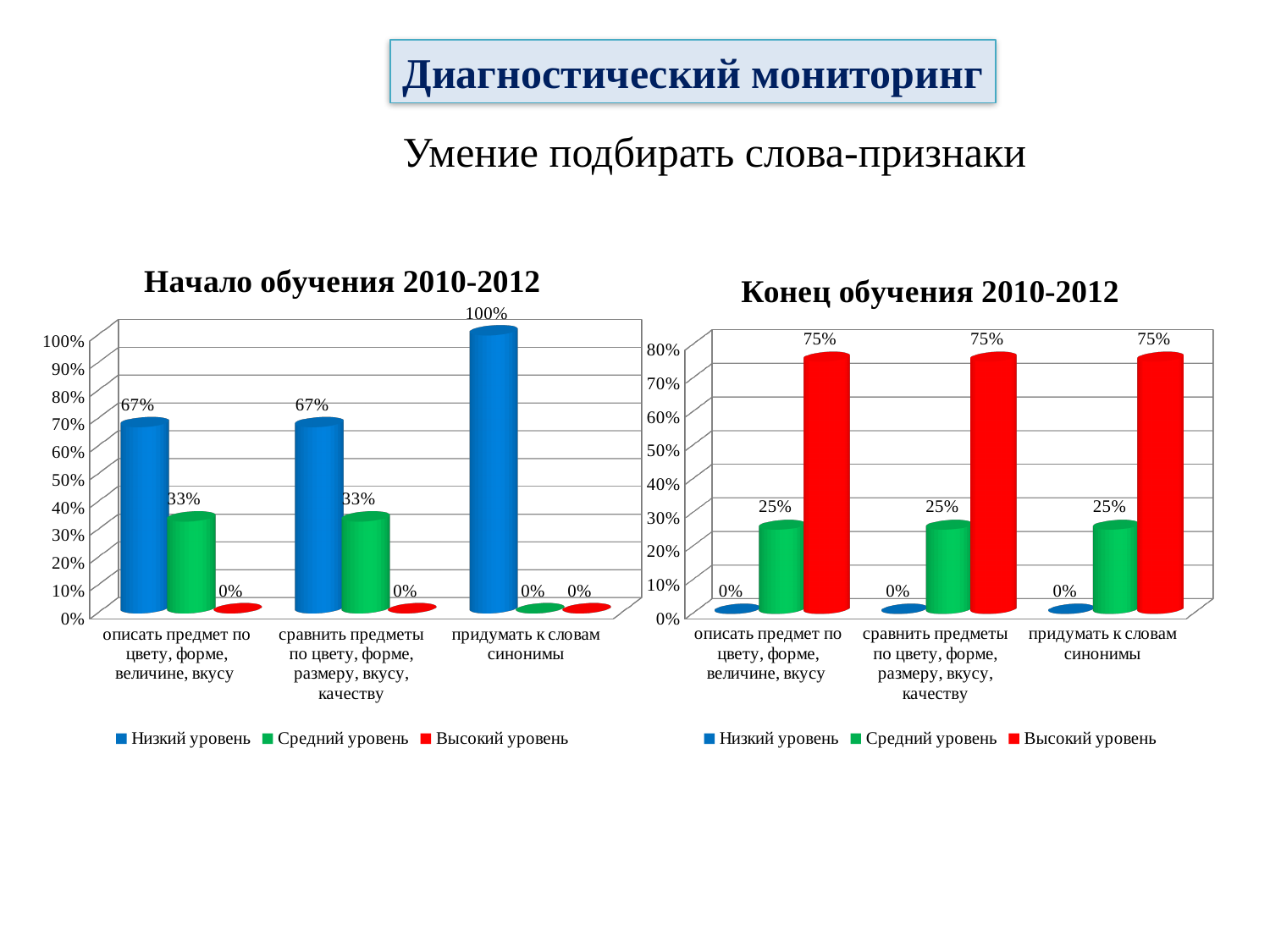
In the chart titled "Начало обучения 2010-2012", what is the difference between "Низкий уровень" and "Средний уровень" for "сравнить предметы по цвету, форме, размеру, вкусу, качеству"? 34% What type of chart is the chart titled "Конец обучения 2010-2012"? bar chart In the chart titled "Конец обучения 2010-2012", what is the value of "Высокий уровень" for "сравнить предметы по цвету, форме, размеру, вкусу, качеству"? 75% How many categories are shown on the x axis of the chart titled "Начало обучения 2010-2012"? 3 How many series does the legend of the chart titled "Конец обучения 2010-2012" list? 3 In the chart titled "Конец обучения 2010-2012", what is the value of "Низкий уровень" for "придумать к словам синонимы"? 0% In the chart titled "Конец обучения 2010-2012", which is larger for "придумать к словам синонимы": "Средний уровень" or "Высокий уровень"? Высокий уровень In the chart titled "Начало обучения 2010-2012", which category has the highest value for "Низкий уровень"? придумать к словам синонимы In the chart titled "Начало обучения 2010-2012", what is the value of "Низкий уровень" for "придумать к словам синонимы"? 100% In the chart titled "Конец обучения 2010-2012", what is the difference between "Высокий уровень" and "Средний уровень" for "описать предмет по цвету, форме, величине, вкусу"? 50% In the chart titled "Начало обучения 2010-2012", what is the value of "Средний уровень" for "описать предмет по цвету, форме, величине, вкусу"? 33% In the chart titled "Начало обучения 2010-2012", which colour represents "Высокий уровень" in the legend? red